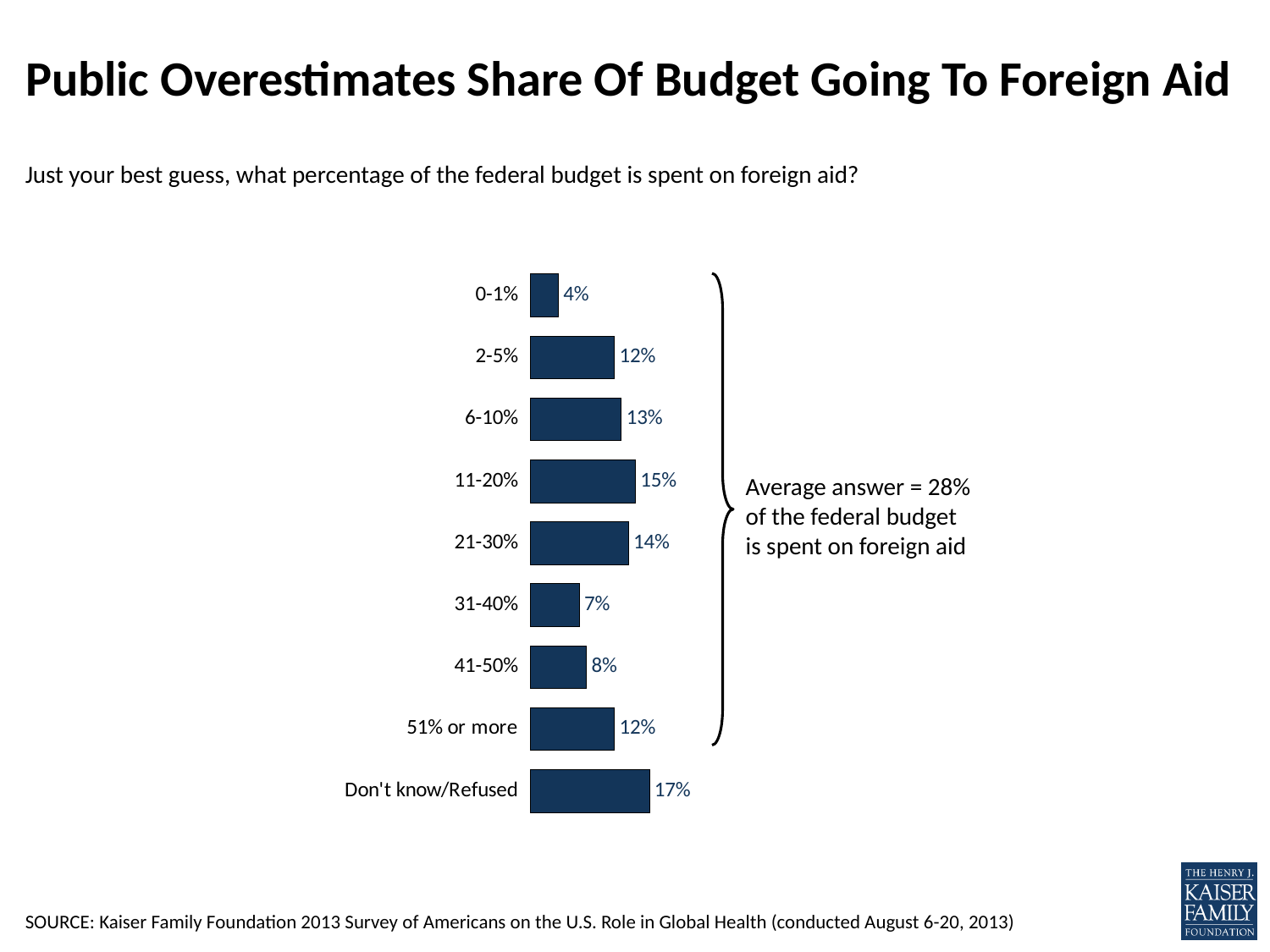
What is the value for the '51% or more' category? 12% Which is larger, the value for 6-10% or the value for 41-50%? 6-10% How many categories are shown in the chart? 9 What kind of chart is shown on the slide? Bar chart Which category has the lowest value? 0-1% According to the annotation on the slide, what is the average answer for the share of the federal budget spent on foreign aid? 28% What percentage of respondents guessed 0-1%? 4% What is the difference between the values for 11-20% and 31-40%? 8% Which category has the highest value? Don't know/Refused What is the value shown for the 'Don't know/Refused' category? 17% What percentage of respondents guessed that 11-20% of the federal budget is spent on foreign aid? 15% What is the title of the slide? Public Overestimates Share Of Budget Going To Foreign Aid